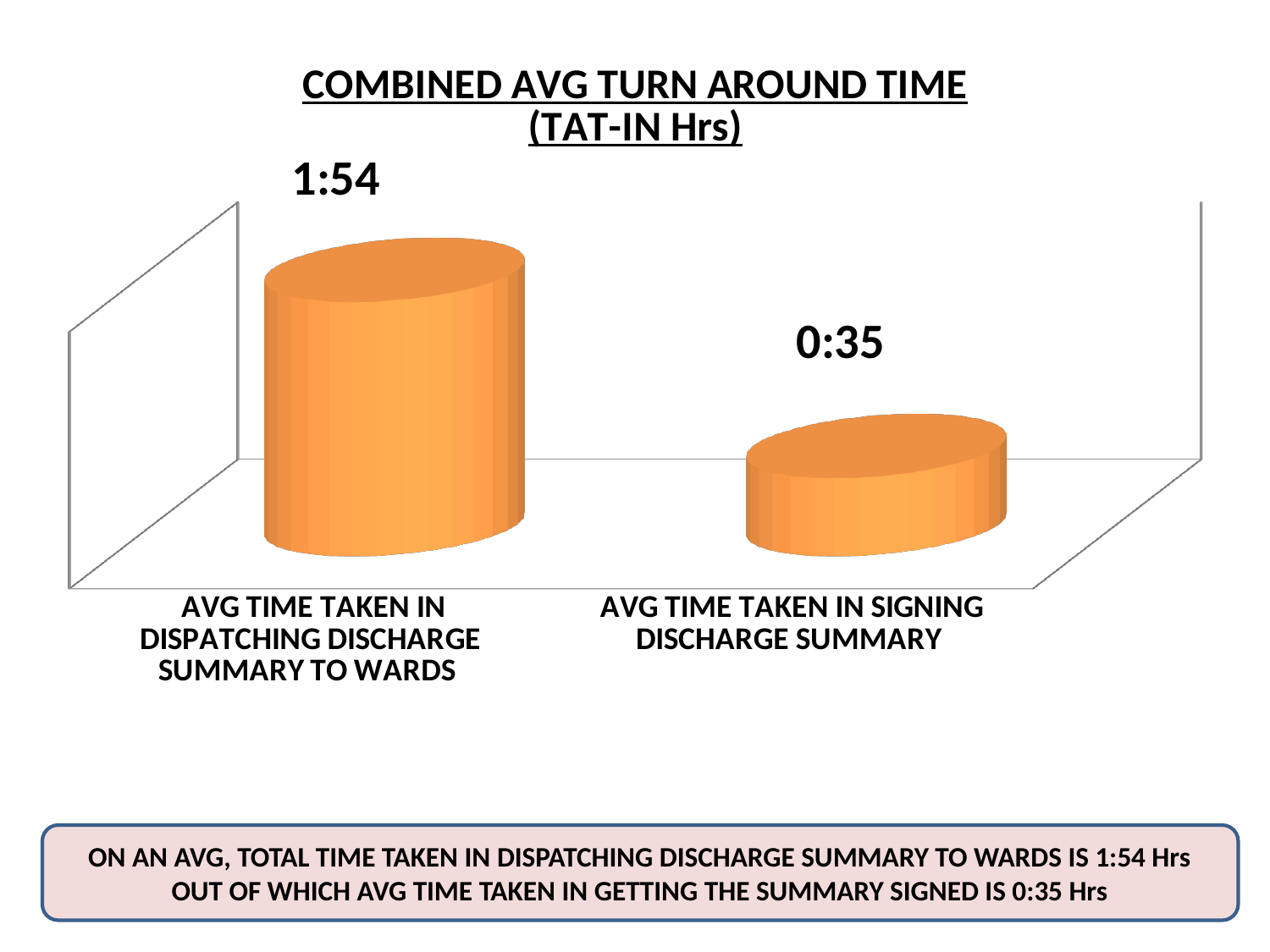
Which category has the lowest value? AVG TIME TAKEN IN SIGNING DISCHARGE SUMMARY How many categories are shown in the chart? 2 What is the title of the chart? COMBINED AVG TURN AROUND TIME (TAT-IN Hrs) Which category has the highest value? AVG TIME TAKEN IN DISPATCHING DISCHARGE SUMMARY TO WARDS What is the value for AVG TIME TAKEN IN SIGNING DISCHARGE SUMMARY? 0:35 What is the difference between the value for AVG TIME TAKEN IN DISPATCHING DISCHARGE SUMMARY TO WARDS and the value for AVG TIME TAKEN IN SIGNING DISCHARGE SUMMARY? 1:19 What colour are the bars in the chart? Orange Which is larger: the value for AVG TIME TAKEN IN DISPATCHING DISCHARGE SUMMARY TO WARDS or the value for AVG TIME TAKEN IN SIGNING DISCHARGE SUMMARY? AVG TIME TAKEN IN DISPATCHING DISCHARGE SUMMARY TO WARDS What is the value for AVG TIME TAKEN IN DISPATCHING DISCHARGE SUMMARY TO WARDS? 1:54 What kind of chart is shown on the slide? Bar chart